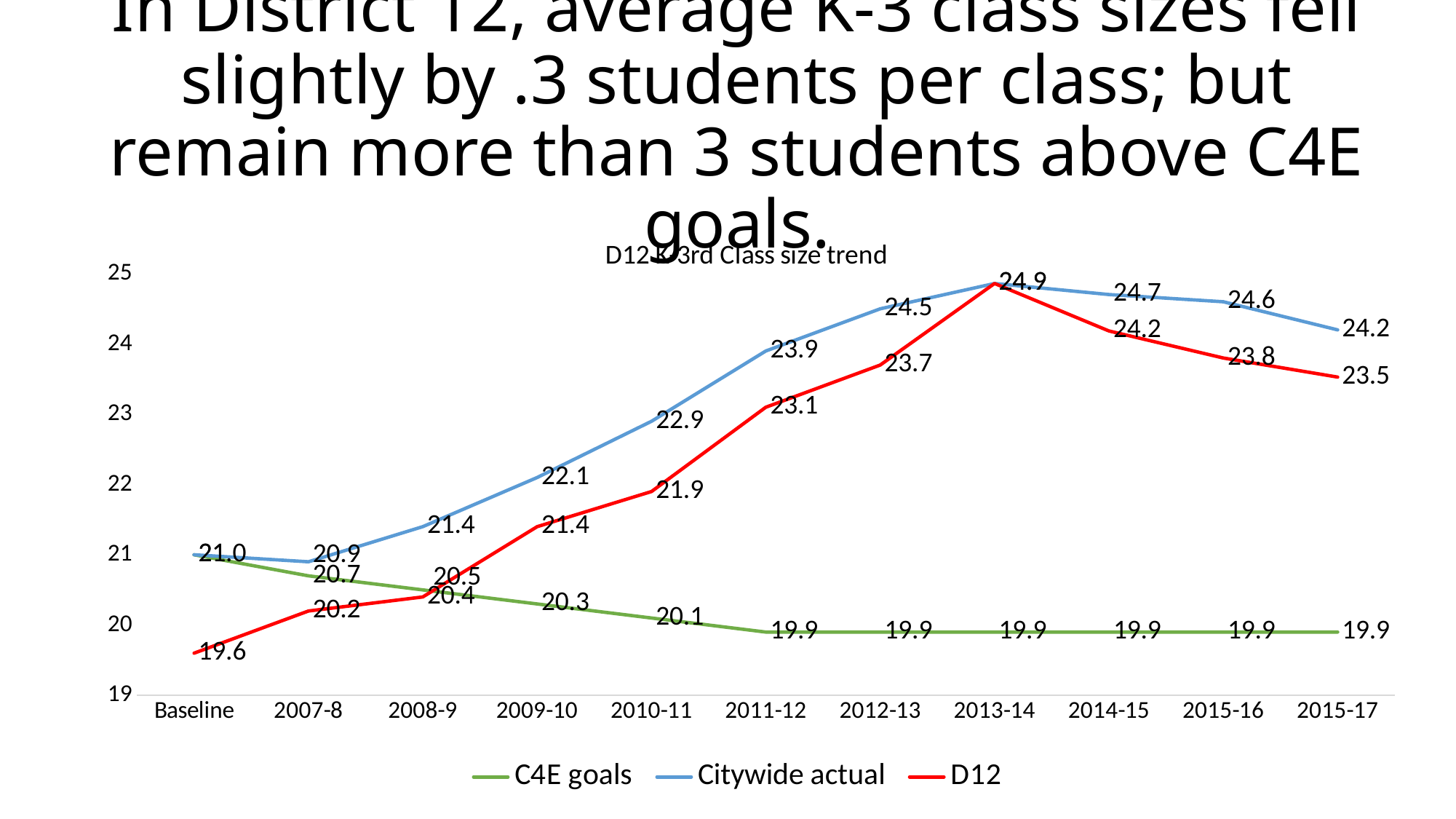
What is the C4E goals value for 2015-17? 19.9 What is the difference between the D12 values for 2015-16 and 2015-17? 0.3 What kind of chart is shown on the slide? line chart How many series does the legend list? 3 At which point is the D12 series lowest? Baseline What is the D12 value for 2010-11? 21.9 Does the C4E goals series rise or fall from Baseline to 2011-12? fall Which is larger in 2014-15, Citywide actual or D12? Citywide actual What is the Citywide actual value for 2011-12? 23.9 In which year does the D12 series reach its highest value? 2013-14 What is the D12 value for 2015-17? 23.5 How many categories are shown on the x axis? 11